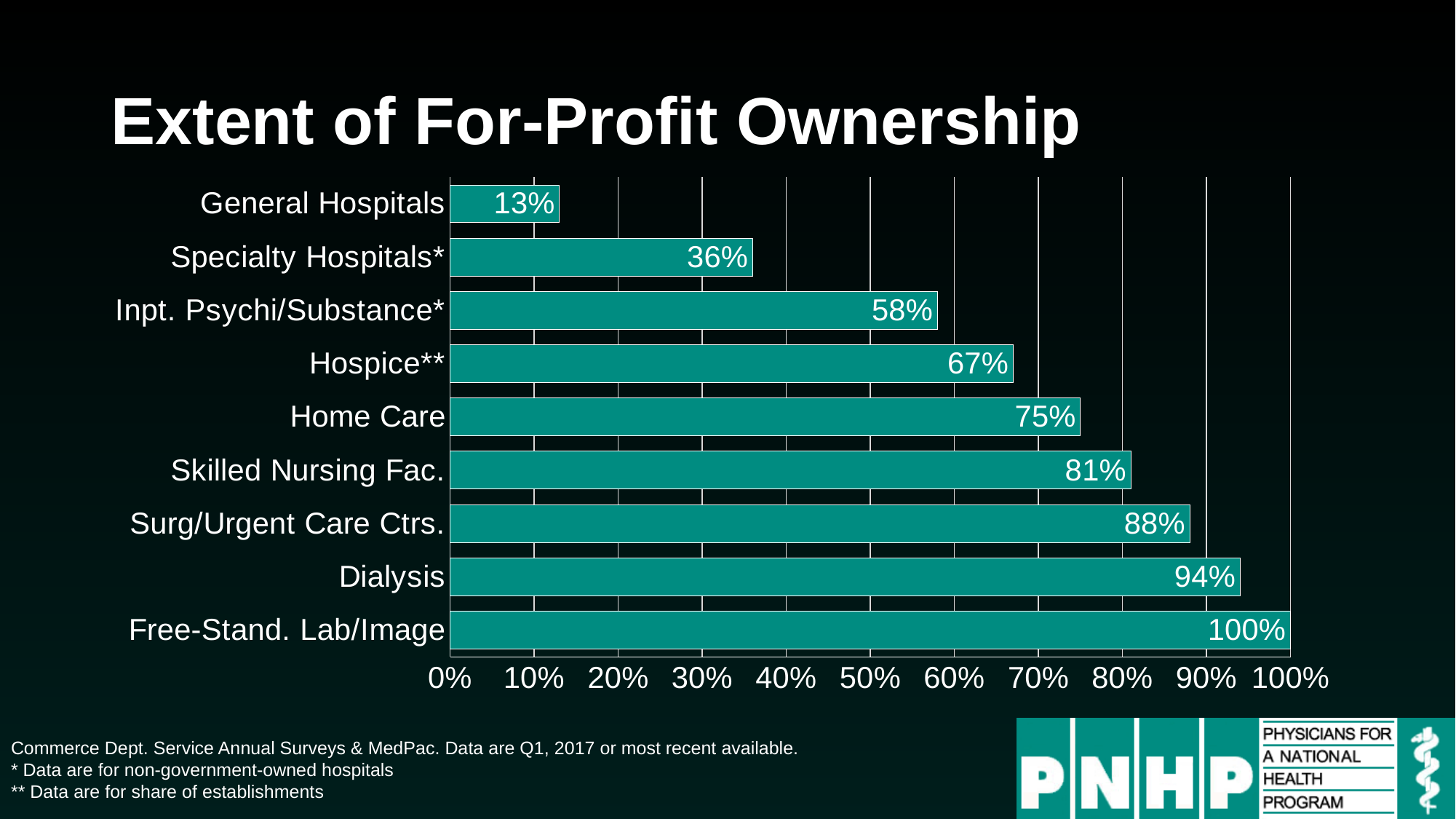
What is the value shown for Hospice**? 67% Is the value for Home Care greater or less than 70%? greater What is the value shown for Dialysis? 94% Which is larger, the value for Specialty Hospitals* or the value for Inpt. Psychi/Substance*? Inpt. Psychi/Substance* What is the title of the slide? Extent of For-Profit Ownership What is the for-profit ownership value for General Hospitals? 13% Which category has the lowest for-profit ownership? General Hospitals What is the difference between the values for Surg/Urgent Care Ctrs. and Home Care? 13% What is the value shown for Skilled Nursing Fac.? 81% Which category has the highest for-profit ownership? Free-Stand. Lab/Image How many categories are shown in the chart? 9 What kind of chart is shown on the slide? Bar chart